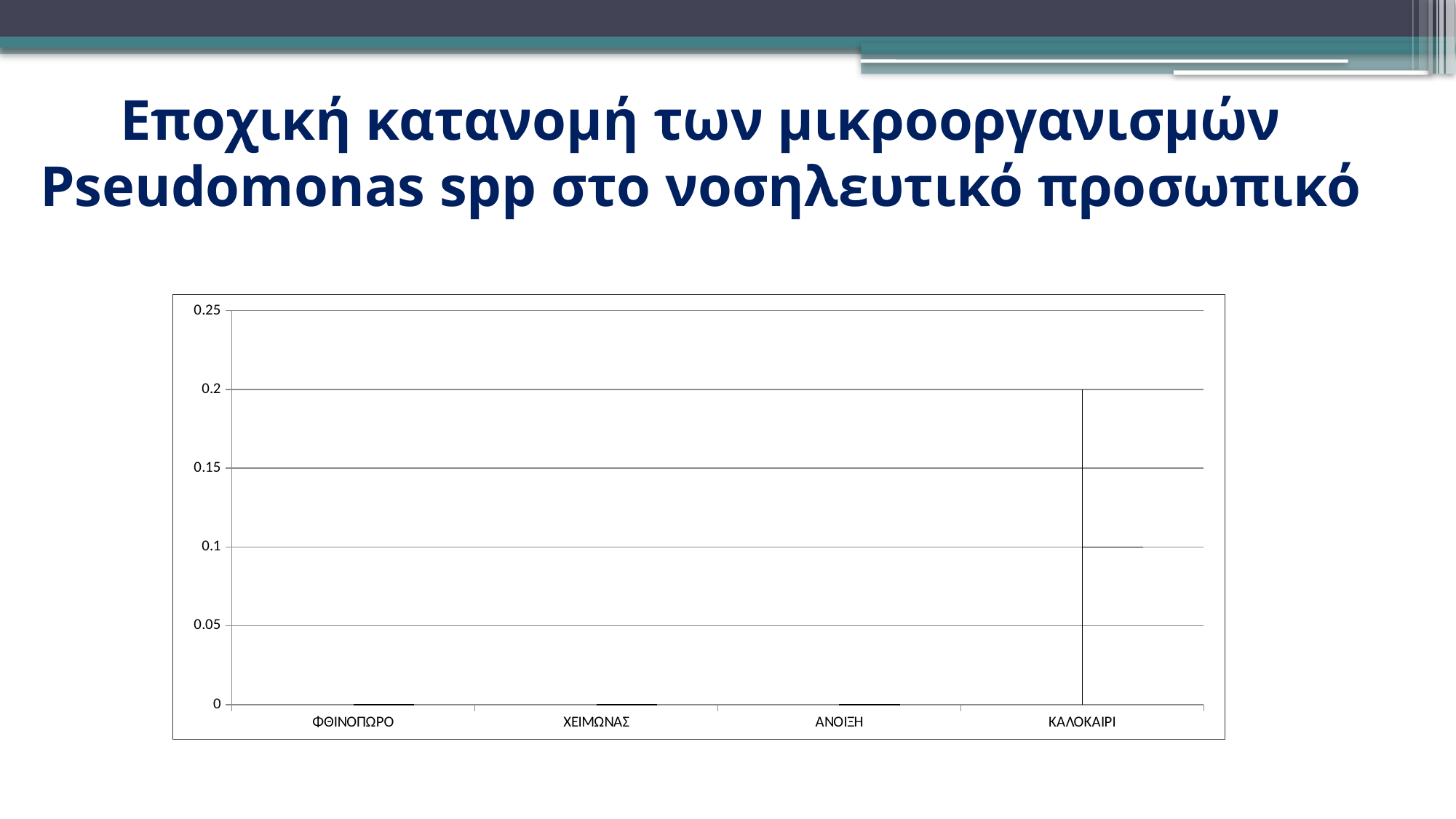
Is the top value for ΚΑΛΟΚΑΙΡΙ greater or less than 0.15? greater Which season has the highest value in the chart? ΚΑΛΟΚΑΙΡΙ Do the values rise or fall from ΑΝΟΙΞΗ to ΚΑΛΟΚΑΙΡΙ? rise What is the highest tick value shown on the vertical axis? 0.25 How many seasons have a value of 0 in the chart? 3 Which has the larger value, ΚΑΛΟΚΑΙΡΙ or ΑΝΟΙΞΗ? ΚΑΛΟΚΑΙΡΙ Which microorganism is named in the slide title? Pseudomonas spp How many seasons (categories) are shown on the x axis of the chart? 4 What is the value shown for ΦΘΙΝΟΠΩΡΟ? 0 What is the difference between the top value for ΚΑΛΟΚΑΙΡΙ and the value for ΑΝΟΙΞΗ? 0.2 What is the value shown for ΧΕΙΜΩΝΑΣ? 0 What is the top value reached by the ΚΑΛΟΚΑΙΡΙ marker? 0.2